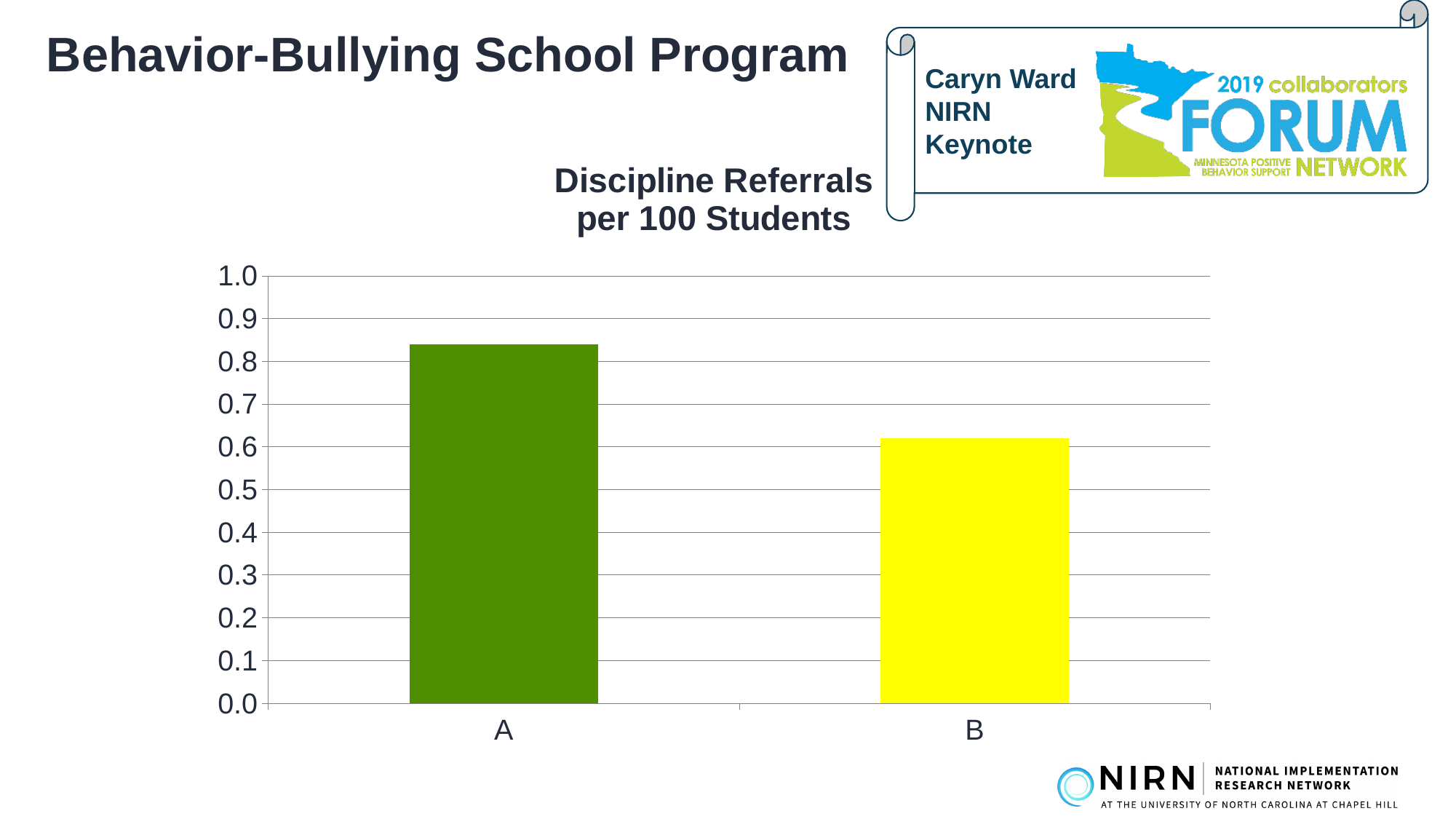
Which category has the lowest value? B What is the title of the chart? Discipline Referrals per 100 Students Which is larger, the value for A or the value for B? A Is the value for B greater or less than 0.5? greater What colour is the bar for category B? yellow Is the value for A greater or less than 0.9? less Is the value for B greater or less than 0.7? less What kind of chart is shown on the slide? bar chart Which category has the highest value? A How many categories are plotted on the x axis? 2 What is the highest value shown on the y axis? 1.0